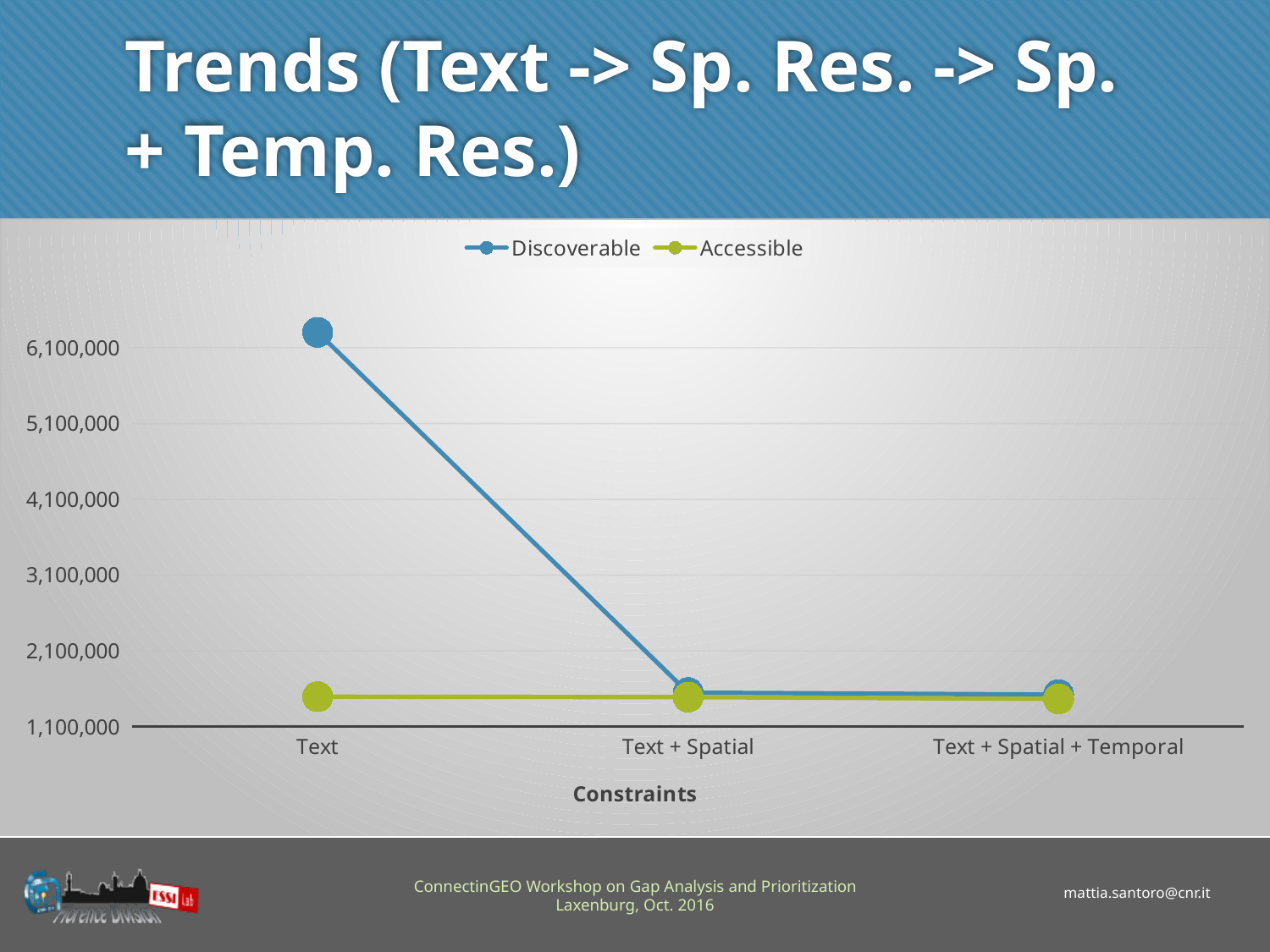
How many categories are shown on the x axis? 3 What is the title of the x axis? Constraints Is the Accessible value for Text greater or less than 2,100,000? less Is the Discoverable value for Text + Spatial greater or less than 2,100,000? less Is the Discoverable value for Text + Spatial + Temporal greater or less than 3,100,000? less For the Text category, which series has the larger value, Discoverable or Accessible? Discoverable How many series does the legend list? 2 Which series are listed in the legend? Discoverable and Accessible Does the Discoverable series rise or fall from Text to Text + Spatial? fall What kind of chart is shown on the slide? line chart For which category is the Discoverable series highest? Text